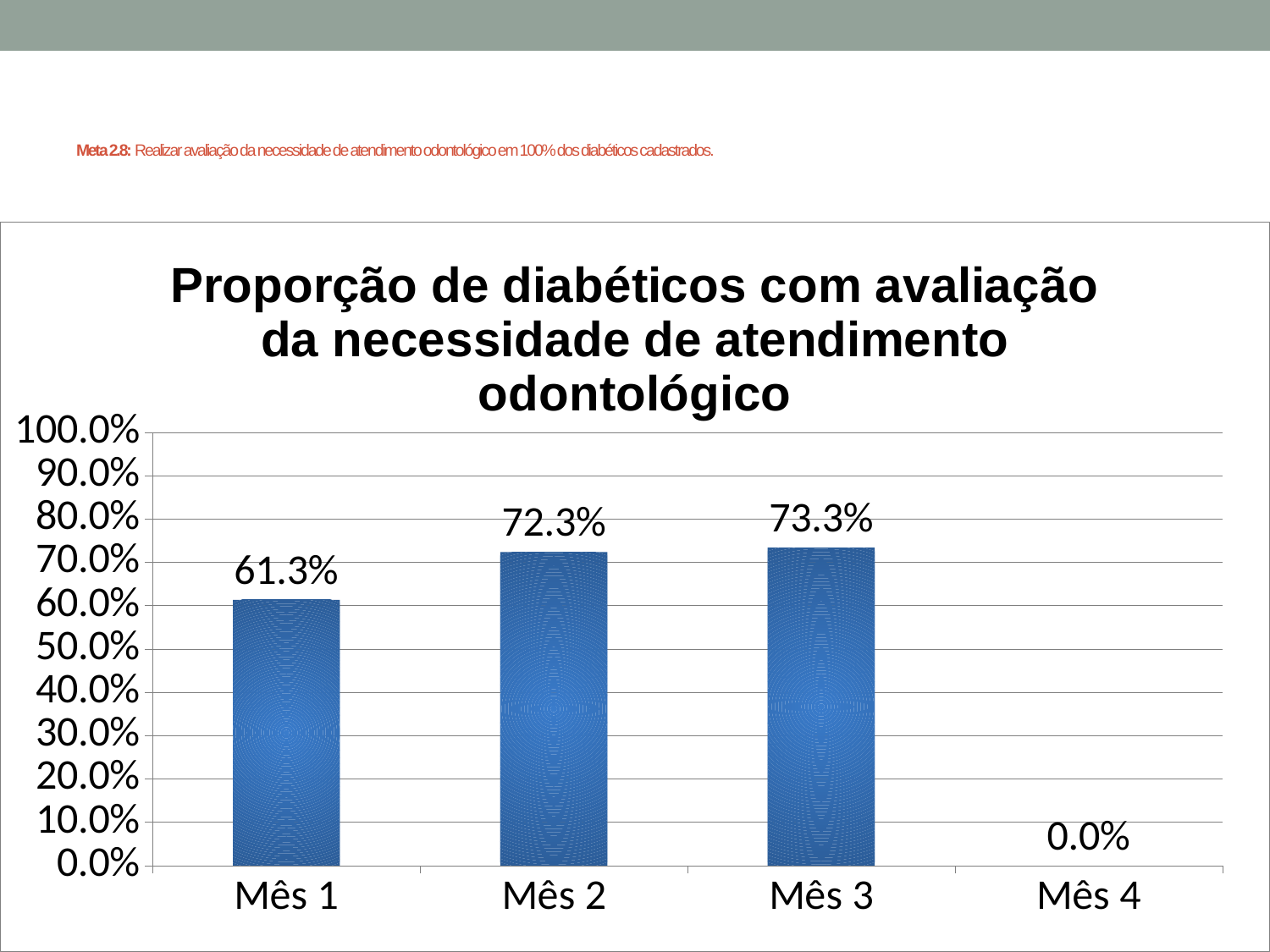
What is the value for Mês 3? 73.3% How many categories are shown on the x axis? 4 What is the value for Mês 2? 72.3% What kind of chart is shown on the slide? bar chart Which category has the highest value? Mês 3 Which is larger, the value for Mês 1 or the value for Mês 2? Mês 2 What is the title of the chart? Proporção de diabéticos com avaliação da necessidade de atendimento odontológico What is the difference between the values for Mês 2 and Mês 1? 11.0% Which category has the lowest value? Mês 4 What is the value for Mês 1? 61.3% What is the value for Mês 4? 0.0% Is the value for Mês 1 greater or less than 70.0%? less